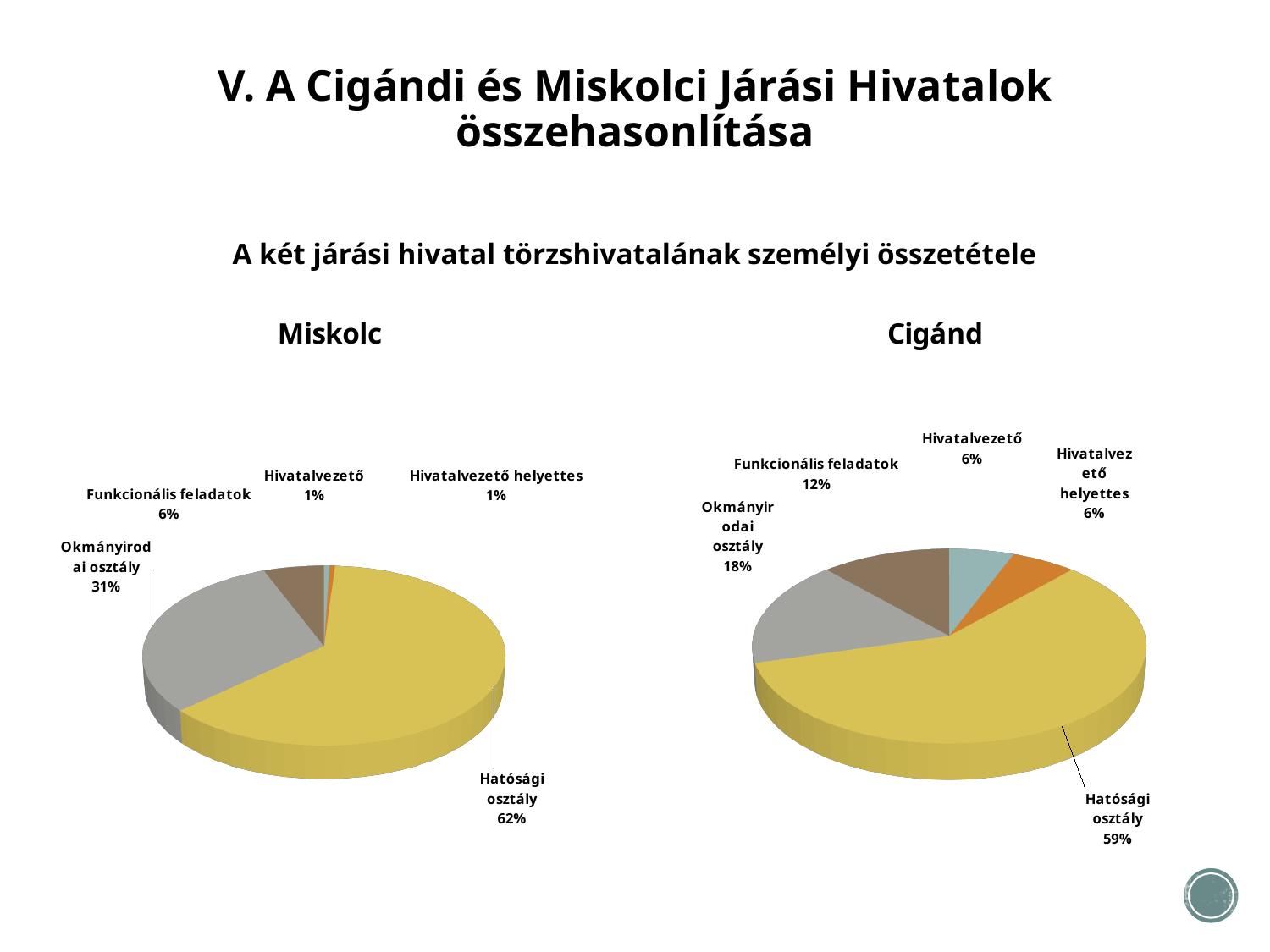
How many slices does the Miskolc pie chart have? 5 Which chart shows a larger share for Funkcionális feladatok, Miskolc or Cigánd? Cigánd In the Miskolc pie chart, what is the difference between the shares of Hatósági osztály and Okmányirodai osztály? 31% In the Cigánd pie chart, what share does Funkcionális feladatok have? 12% In the Cigánd pie chart, which category has the smallest slice, Okmányirodai osztály or Funkcionális feladatok? Funkcionális feladatok In the Miskolc pie chart, what share does Hivatalvezető have? 1% What type of chart is used for Cigánd? Pie chart In the Cigánd pie chart, what is the difference between the shares of Hatósági osztály and Okmányirodai osztály? 41% In the Miskolc pie chart, what share does Hatósági osztály have? 62% In the Cigánd pie chart, what share does Okmányirodai osztály have? 18% In the Cigánd pie chart, which category has the largest slice? Hatósági osztály In the Miskolc pie chart, which category has the largest slice? Hatósági osztály